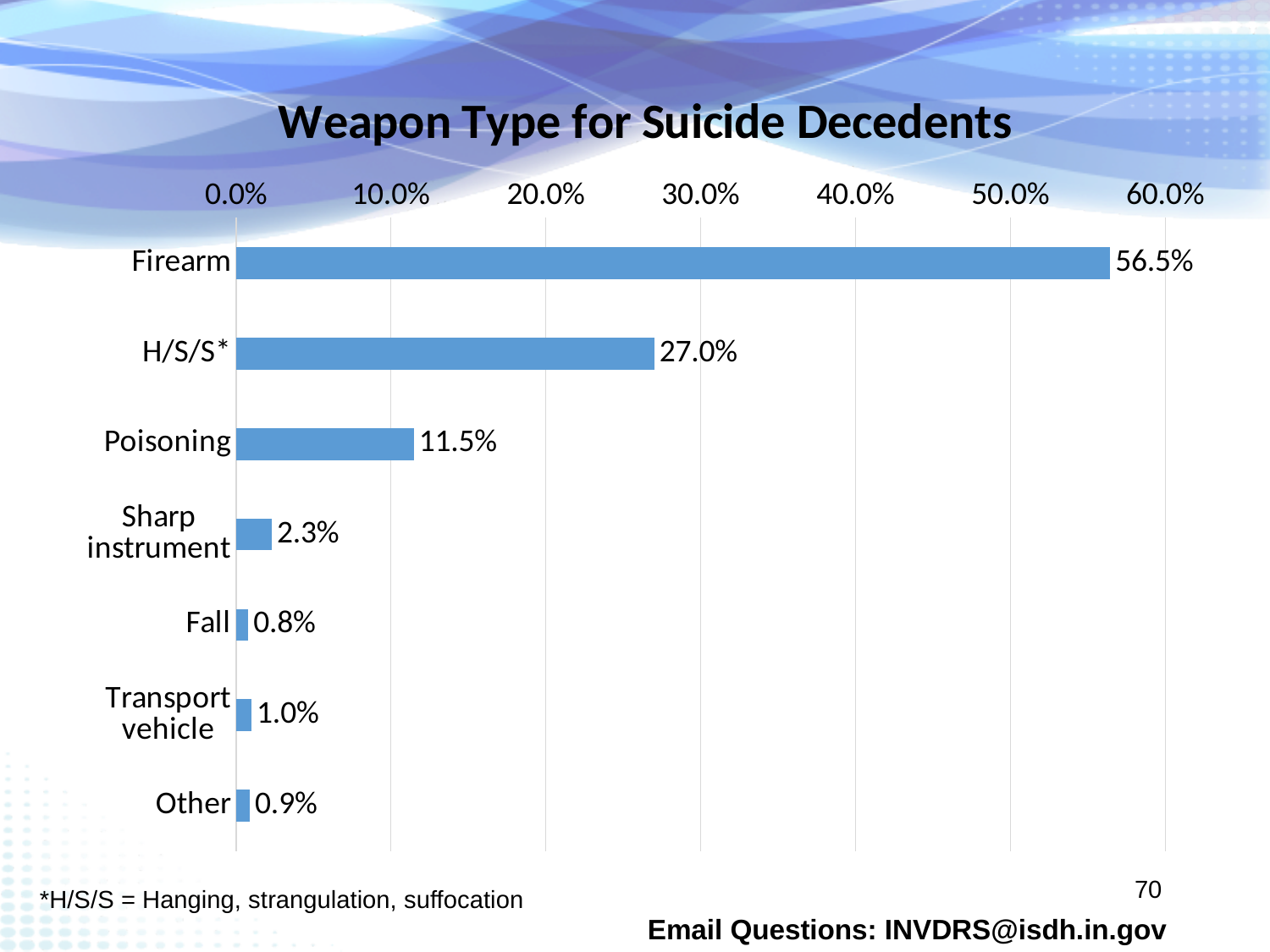
What is the difference between the values for Firearm and H/S/S*? 29.5% Is the value for H/S/S* greater or less than 30.0%? less Which weapon type has the highest value? Firearm What is the value for Firearm? 56.5% Which weapon type has the lowest value? Fall Which is larger, the value for Sharp instrument or the value for Other? Sharp instrument What is the value for Transport vehicle? 1.0% What kind of chart is shown on the slide? bar chart How many weapon type categories are shown in the chart? 7 What is the value for Poisoning? 11.5% According to the footnote, what does H/S/S stand for? Hanging, strangulation, suffocation What is the title of the chart? Weapon Type for Suicide Decedents